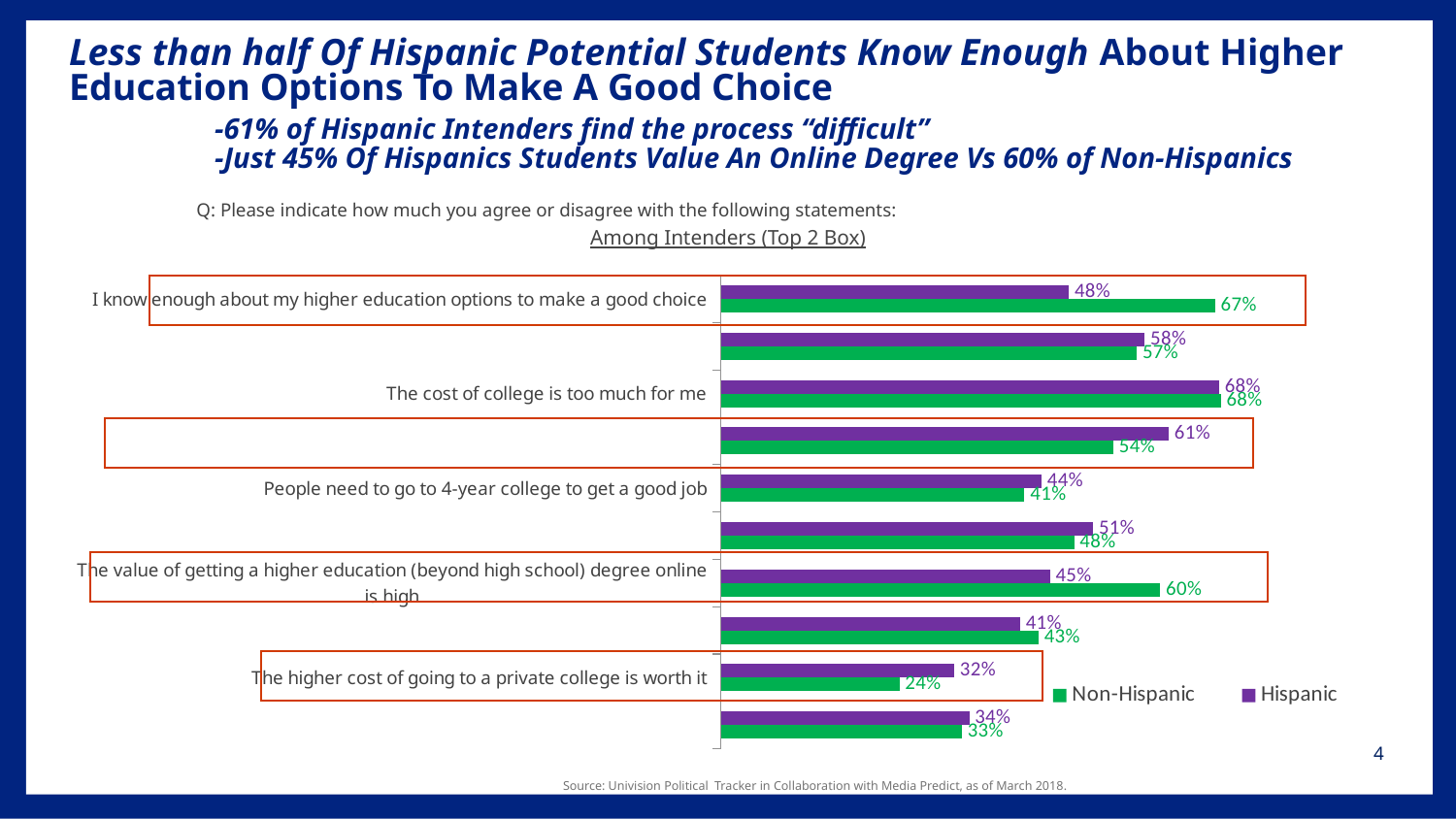
What is the Hispanic value for "I know enough about my higher education options to make a good choice"? 48% What is the Non-Hispanic value for "People need to go to 4-year college to get a good job"? 41% What is the Non-Hispanic value for "The value of getting a higher education (beyond high school) degree online is high"? 60% How many series does the chart legend list? 2 What kind of chart is shown on the slide? bar chart What is the difference between the Non-Hispanic and Hispanic values for "I know enough about my higher education options to make a good choice"? 19% What is the difference between the Non-Hispanic and Hispanic values for "The value of getting a higher education (beyond high school) degree online is high"? 15% For "The higher cost of going to a private college is worth it", which group has the larger value, Hispanic or Non-Hispanic? Hispanic Which colour represents the Non-Hispanic series in the chart? green What is the Non-Hispanic value for "I know enough about my higher education options to make a good choice"? 67% What is the Hispanic value for "The higher cost of going to a private college is worth it"? 32% For "The cost of college is too much for me", what value is shown for both Hispanic and Non-Hispanic? 68%